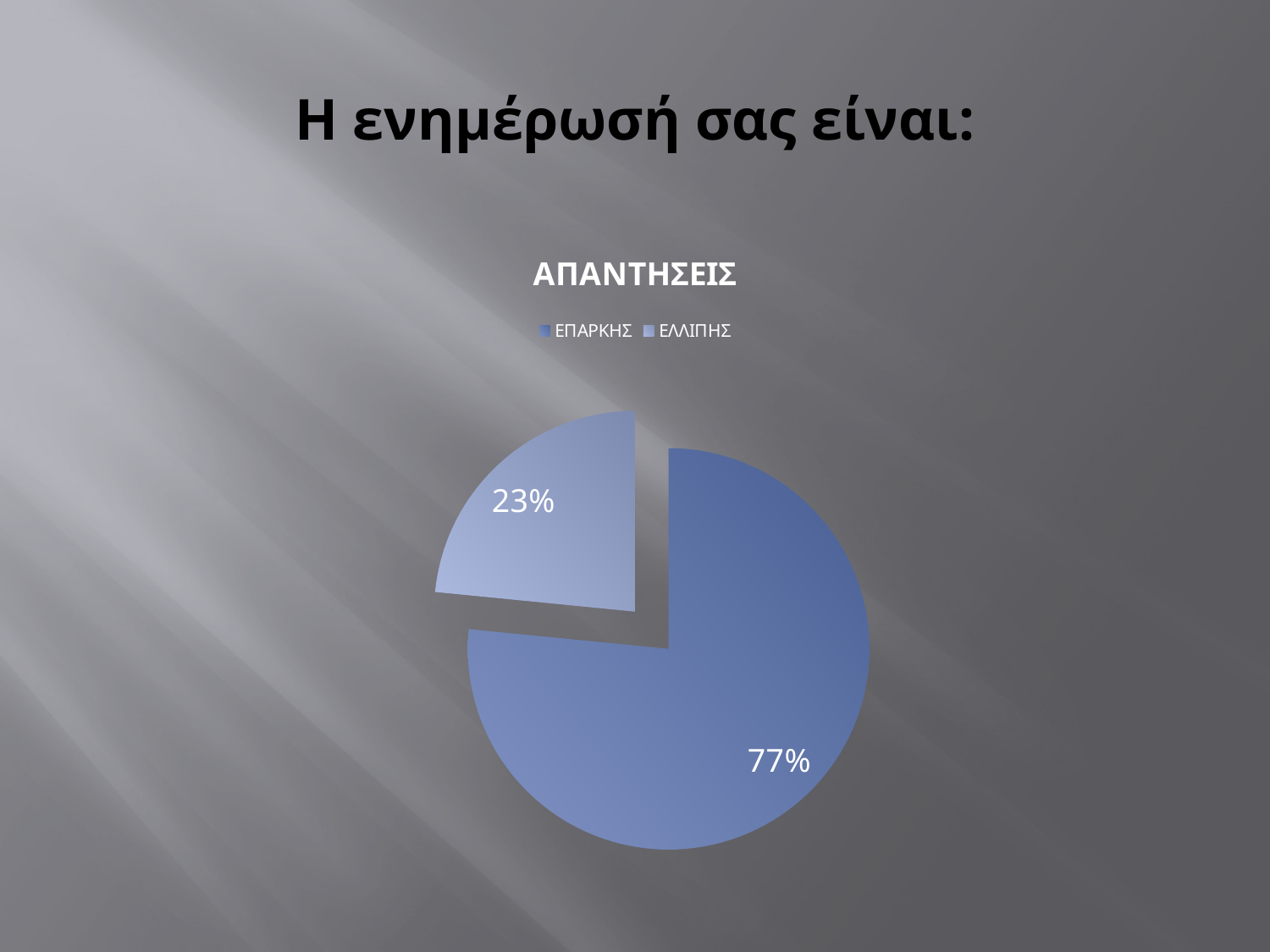
Which slice is pulled out (exploded) from the pie? ΕΛΛΙΠΗΣ What is the difference in percentage points between the ΕΠΑΡΚΗΣ and ΕΛΛΙΠΗΣ slices? 54 What is the title of the chart? ΑΠΑΝΤΗΣΕΙΣ What share of the pie does ΕΛΛΙΠΗΣ represent? 23% Which category has the smallest slice of the pie? ΕΛΛΙΠΗΣ How many slices does the pie chart have? 2 How many entries does the legend list? 2 Which slice is larger, ΕΠΑΡΚΗΣ or ΕΛΛΙΠΗΣ? ΕΠΑΡΚΗΣ What share of the pie does ΕΠΑΡΚΗΣ represent? 77% What kind of chart is shown on the slide? pie chart Which category has the largest slice of the pie? ΕΠΑΡΚΗΣ